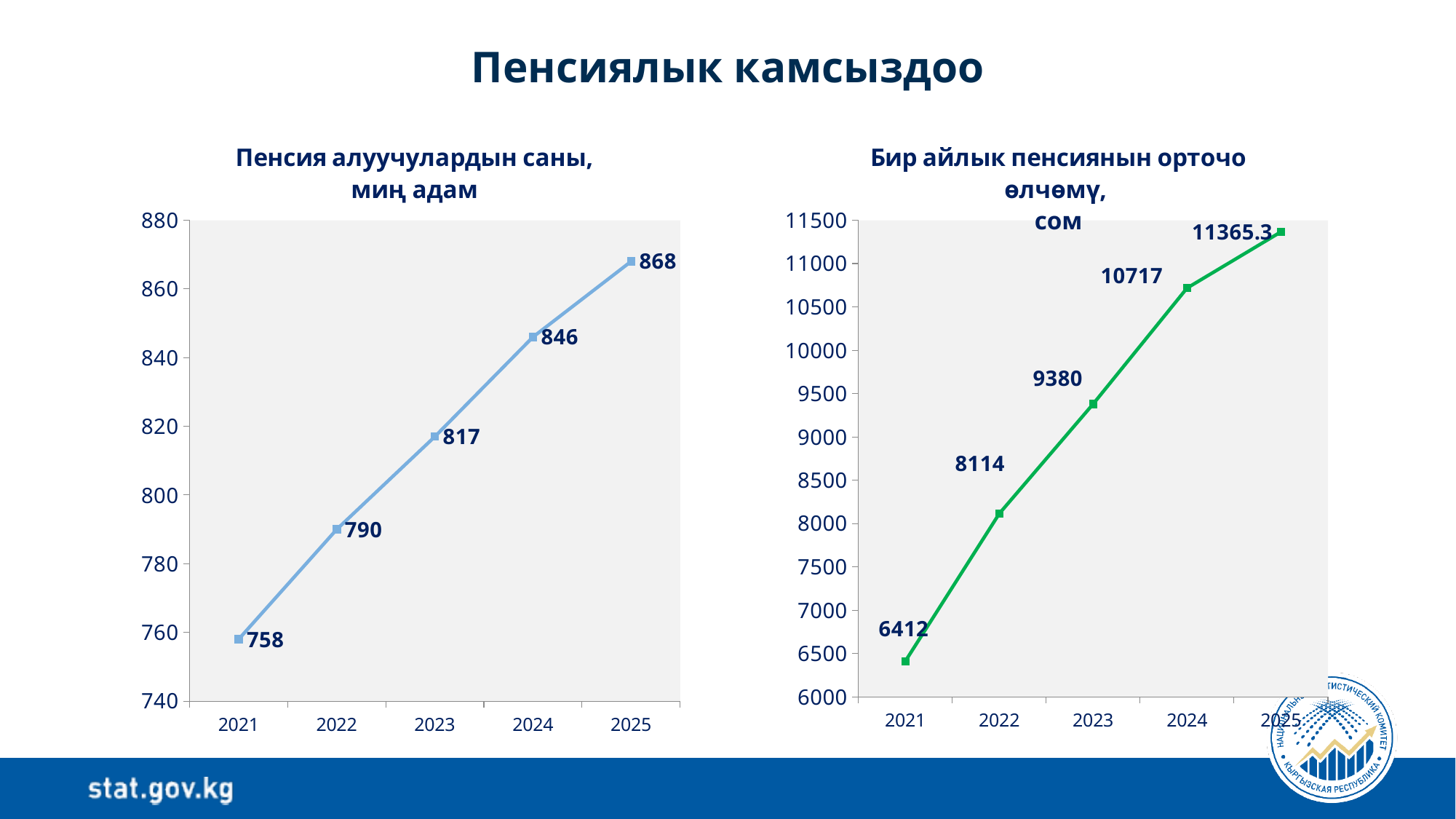
In the right chart 'Бир айлык пенсиянын орточо өлчөмү, сом', what is the difference between the 2024 and 2023 values? 1337 In the right chart 'Бир айлык пенсиянын орточо өлчөмү, сом', what is the value for 2025? 11365.3 In the left chart 'Пенсия алуучулардын саны, миң адам', which year has the highest value? 2025 In the left chart 'Пенсия алуучулардын саны, миң адам', do the values rise or fall from 2021 to 2025? rise What is the main title of the slide? Пенсиялык камсыздоо How many years are plotted in the left chart 'Пенсия алуучулардын саны, миң адам'? 5 In the right chart 'Бир айлык пенсиянын орточо өлчөмү, сом', which is larger: the value for 2022 or the value for 2023? 2023 What kind of chart is the right chart 'Бир айлык пенсиянын орточо өлчөмү, сом'? line chart In the left chart 'Пенсия алуучулардын саны, миң адам', what is the difference between the 2025 and 2021 values? 110 In the right chart 'Бир айлык пенсиянын орточо өлчөмү, сом', which year has the lowest value? 2021 In the left chart 'Пенсия алуучулардын саны, миң адам', is the value for 2024 greater or less than 840? greater In the left chart 'Пенсия алуучулардын саны, миң адам', what is the value for 2023? 817